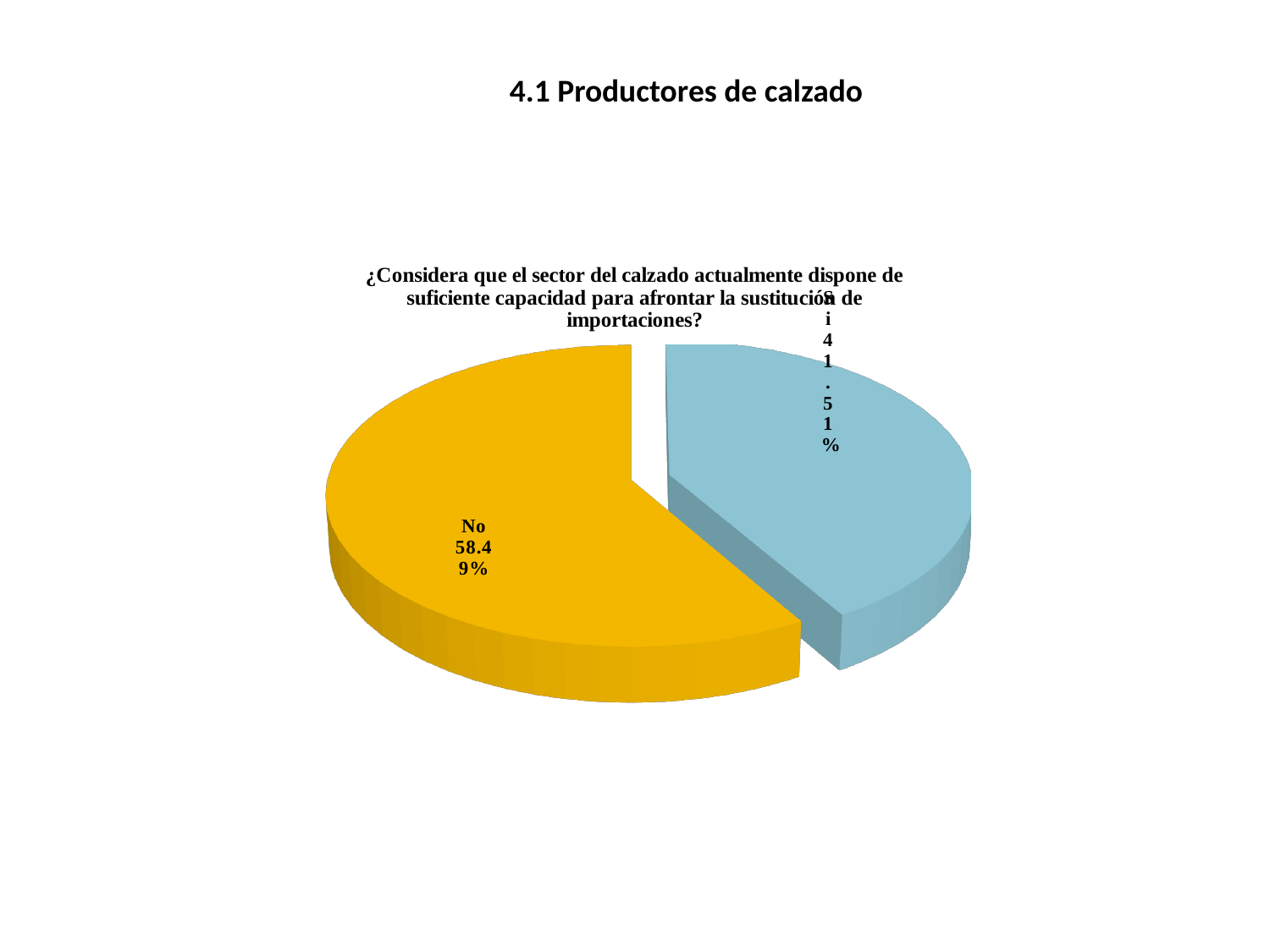
Which response received a larger share, "Si" or "No"? No Which response has the largest share of the pie? No Which response has the smallest share of the pie? Si What percentage of shoe producers answered "No"? 58.49% What is the title of the slide? 4.1 Productores de calzado What colour is the "No" slice of the pie? Yellow What kind of chart is shown on the slide? Pie chart What percentage of shoe producers answered "Si"? 41.51% What is the difference in percentage points between the "No" and "Si" responses? 16.98 How many slices does the pie chart have? 2 Is the share for "No" greater or less than 50%? greater